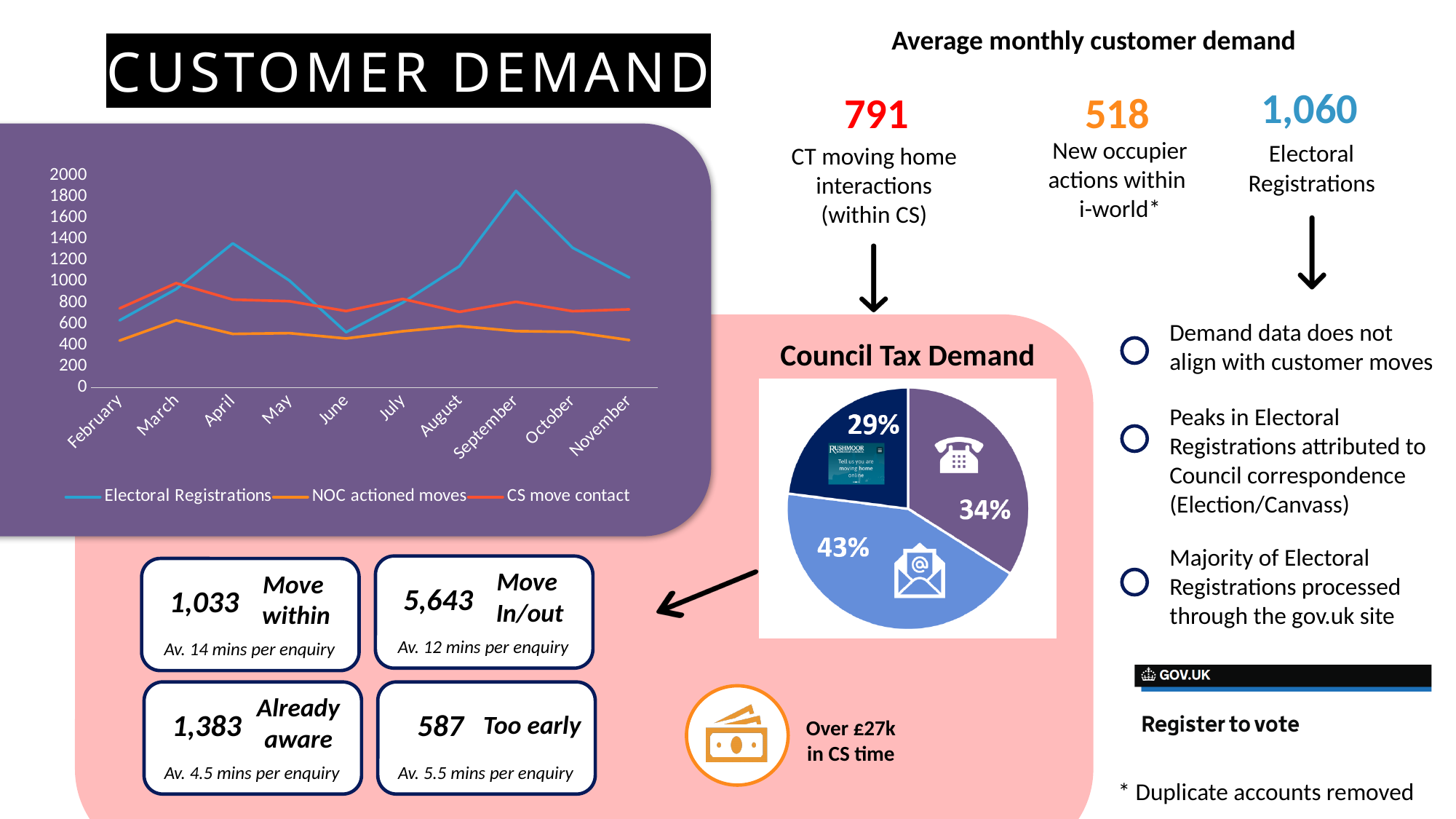
In the Council Tax Demand pie chart, what is the share of the largest slice? 43% In the line chart on the left, which series is higher in April: Electoral Registrations or NOC actioned moves? Electoral Registrations In the line chart on the left, in which month does Electoral Registrations reach its highest value? September What kind of chart is the chart on the purple panel on the left of the slide? line chart How many series does the legend of the line chart on the left list? 3 In the line chart on the left, is the value for NOC actioned moves in April greater or less than 600? less In the line chart on the left, does Electoral Registrations rise or fall from September to November? fall In the line chart on the left, is the value for Electoral Registrations in September greater or less than 1600? greater In the Council Tax Demand pie chart, what is the share of the smallest slice? 29% In the line chart on the left, in which month is Electoral Registrations at its lowest? June How many months are shown on the x axis of the line chart on the left? 10 In the Council Tax Demand pie chart, how many slices are there? 3